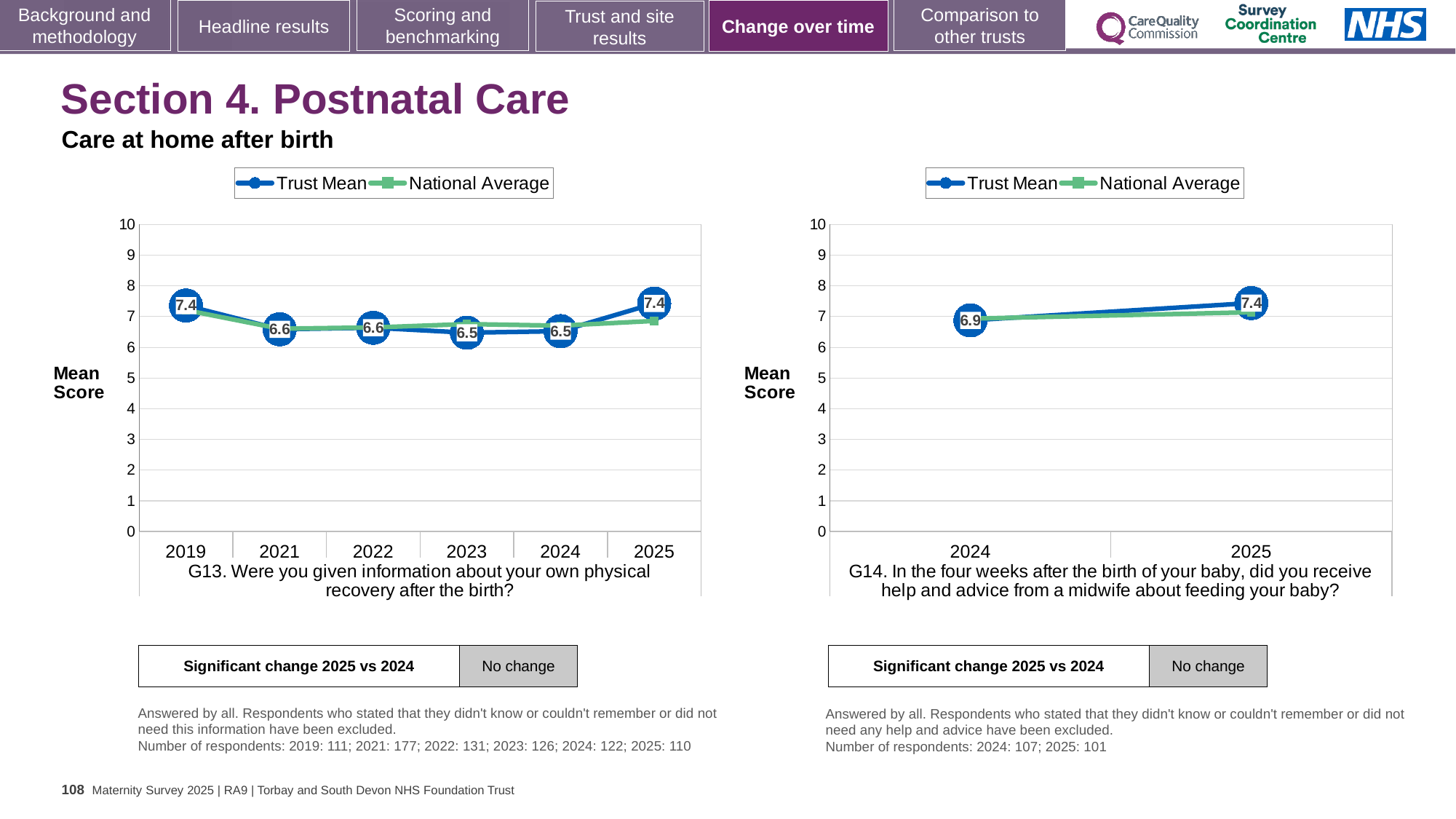
In the G14 chart on the right, what is the Trust Mean score for 2024? 6.9 In the G13 chart on the left, what is the Trust Mean score for 2019? 7.4 In the G13 chart on the left, is the National Average value for 2025 greater or less than 6? greater How many series does the legend of the G14 chart on the right list? 2 In the G13 chart on the left, what is the difference between the Trust Mean scores for 2025 and 2024? 0.9 What type of chart is the G14 chart on the right? line chart In the G13 chart on the left, what is the Trust Mean score for 2023? 6.5 In the G14 chart on the right, what is the difference between the Trust Mean scores for 2025 and 2024? 0.5 In the G13 chart on the left, is the Trust Mean score for 2021 larger or smaller than the score for 2025? smaller In the G14 chart on the right, which year has the higher Trust Mean score? 2025 In the G13 chart on the left, what is the Trust Mean score for 2025? 7.4 How many years are shown on the x axis of the G13 chart on the left? 6